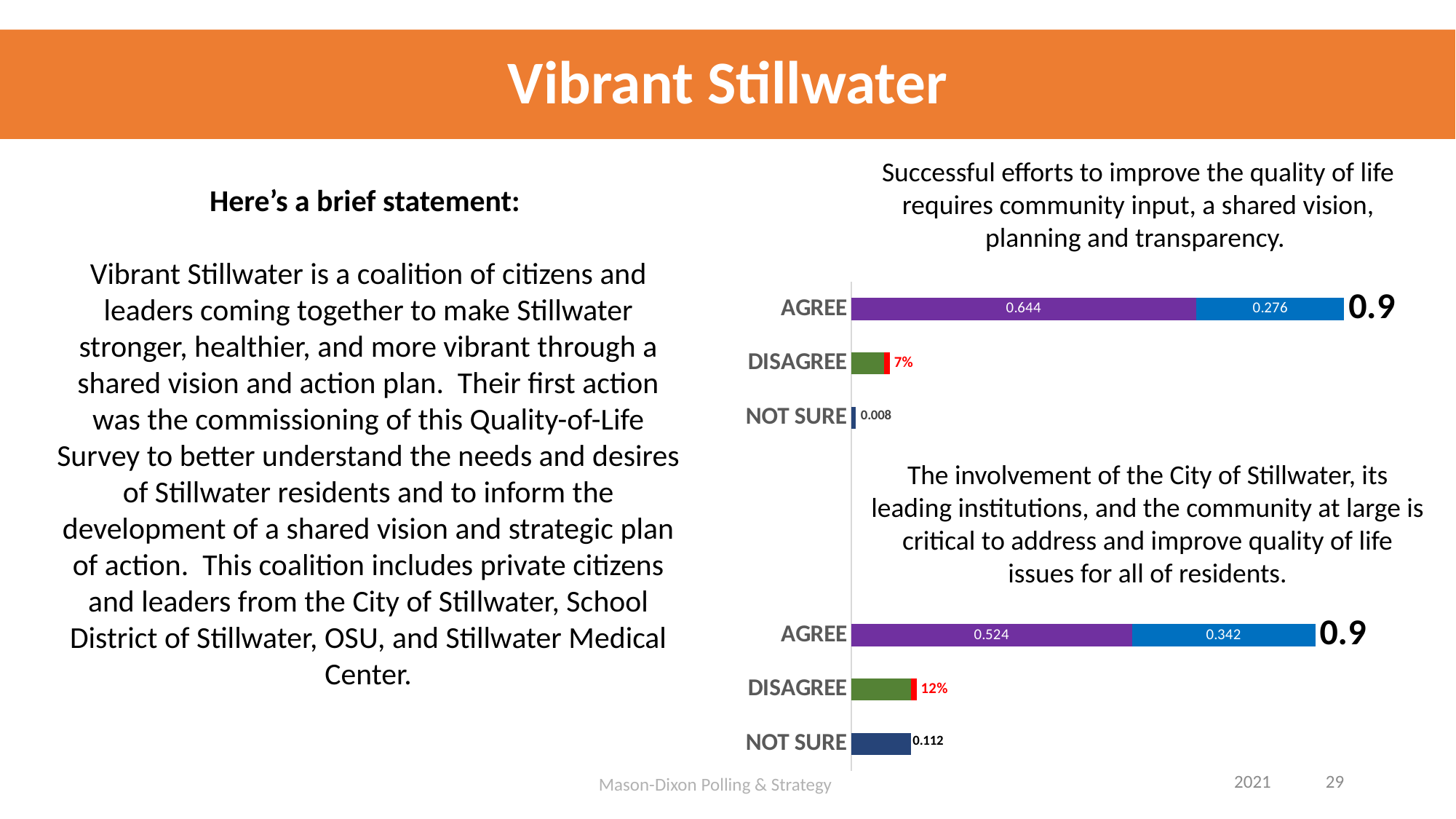
In the bottom chart ("The involvement of the City of Stillwater..."), what is the value of the purple segment of the AGREE bar? 0.524 In the top chart, what is the value of the blue segment of the AGREE bar? 0.276 How many categories are shown in the bottom chart? 3 In the top chart, what value is shown for NOT SURE? 0.008 In the bottom chart, what value is shown for DISAGREE? 12% In the top chart, what is the difference between the purple and blue segments of the AGREE bar? 0.368 In the top chart ("Successful efforts to improve the quality of life..."), what is the total value shown for the AGREE bar? 0.9 In the bottom chart, which category has the lowest value? NOT SURE In the top chart, what value is shown for DISAGREE? 7% In the bottom chart, what value is shown for NOT SURE? 0.112 In the top chart, what is the value of the purple segment of the AGREE bar? 0.644 In the bottom chart, what is the value of the blue segment of the AGREE bar? 0.342